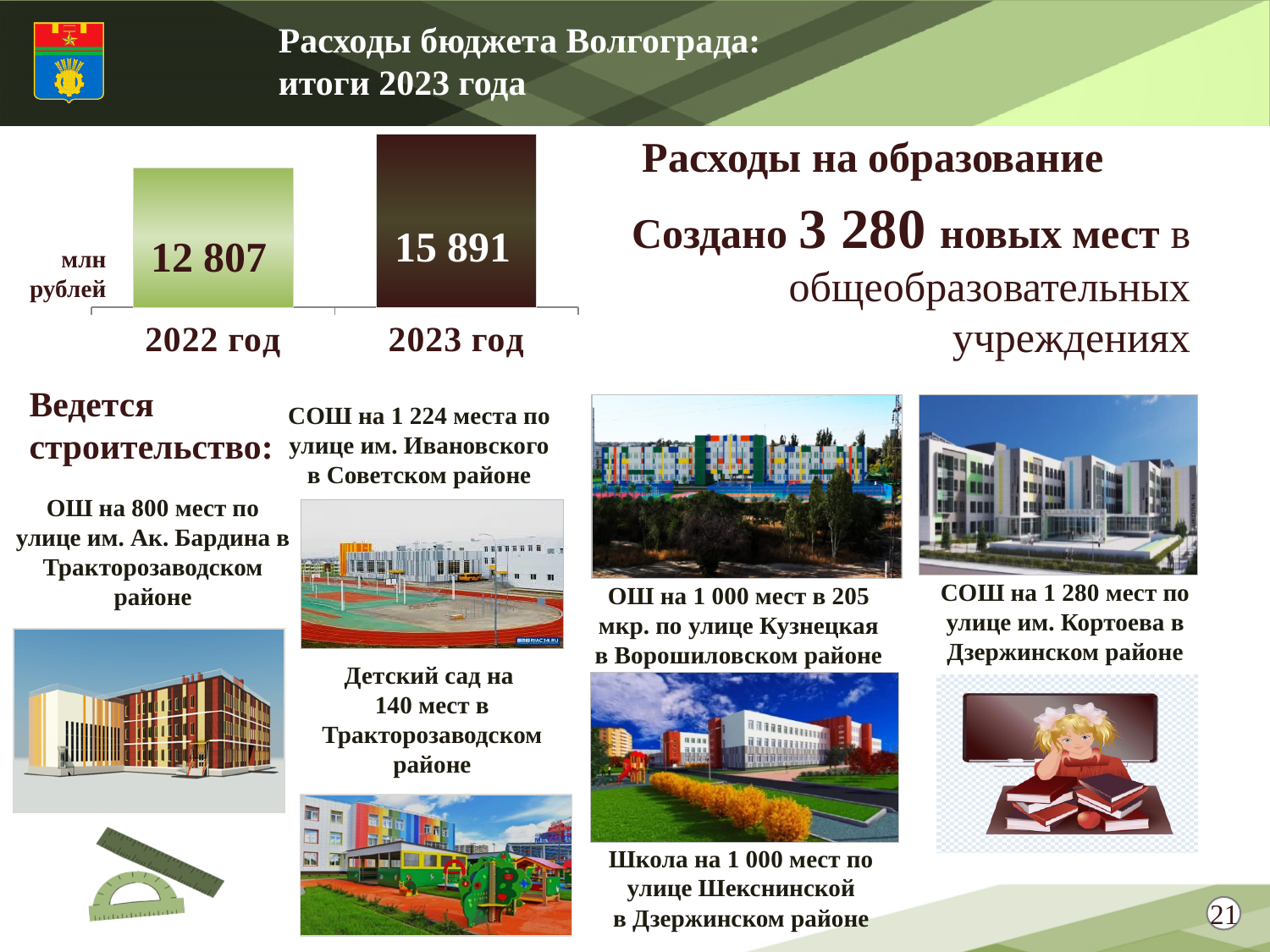
What type of chart is used to show the education spending figures? bar chart By how much does the value for 2023 год exceed the value for 2022 год in the bar chart? 3 084 What is the value for 2023 год in the bar chart? 15 891 Which year has the higher value in the bar chart? 2023 год What colour is the bar for 2022 год in the bar chart? green In what units are the values in the bar chart expressed? млн рублей Do the values in the bar chart rise or fall from 2022 год to 2023 год? rise Which year has the lower value in the bar chart? 2022 год Is the value for 2023 год larger or smaller than the value for 2022 год in the bar chart? larger How many bars are shown in the bar chart? 2 What is the value for 2022 год in the bar chart? 12 807